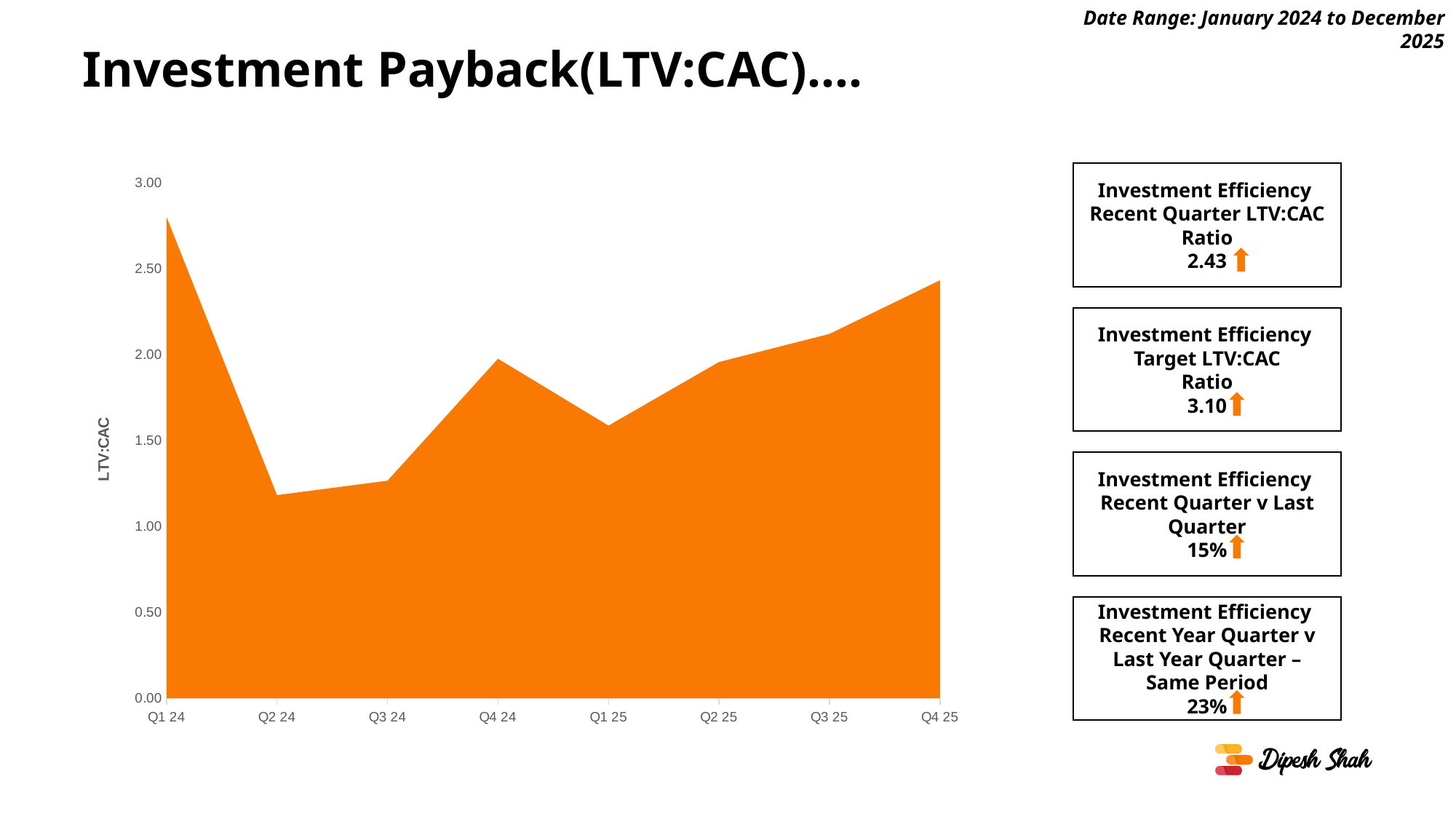
Which is larger, the LTV:CAC value for Q1 24 or for Q4 25? Q1 24 What is the label on the y axis of the chart? LTV:CAC Which quarter has the highest LTV:CAC value in the chart? Q1 24 Which quarter has the lowest LTV:CAC value in the chart? Q2 24 How many quarters are plotted on the x axis of the chart? 8 Which is larger, the LTV:CAC value for Q4 24 or for Q1 25? Q4 24 Is the LTV:CAC value for Q4 25 greater or less than 2.00? greater Is the LTV:CAC value for Q3 25 greater or less than 2.50? less Is the LTV:CAC value for Q2 24 greater or less than 1.50? less What kind of chart is shown on the slide? area chart Do the LTV:CAC values rise or fall from Q1 25 to Q4 25? rise